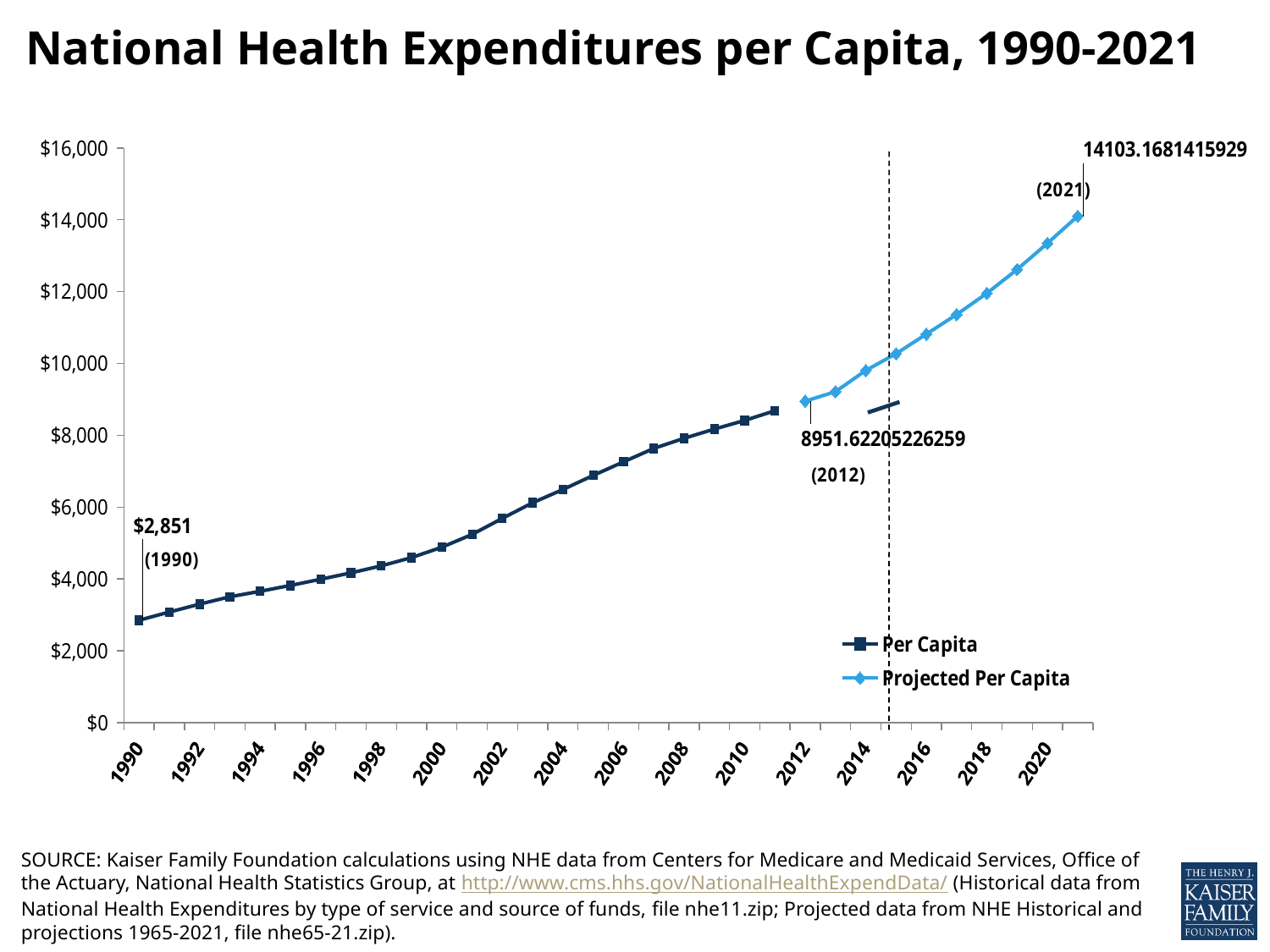
How many series does the legend list? 2 What is the projected per capita value labeled for 2021? 14103.1681415929 Do the values rise or fall from 1990 to 2021? Rise Is the projected value for 2019 greater or less than $12,000? greater Which year has the highest value on the chart? 2021 What is the per capita value shown for 1990? $2,851 Which year has the lowest value on the chart? 1990 What is the value labeled for 2012? 8951.62205226259 Is the value for 2005 greater or less than $8,000? less What are the two series named in the legend? Per Capita and Projected Per Capita What kind of chart is shown on the slide? Line chart Is the value for 2000 greater or less than $4,000? greater